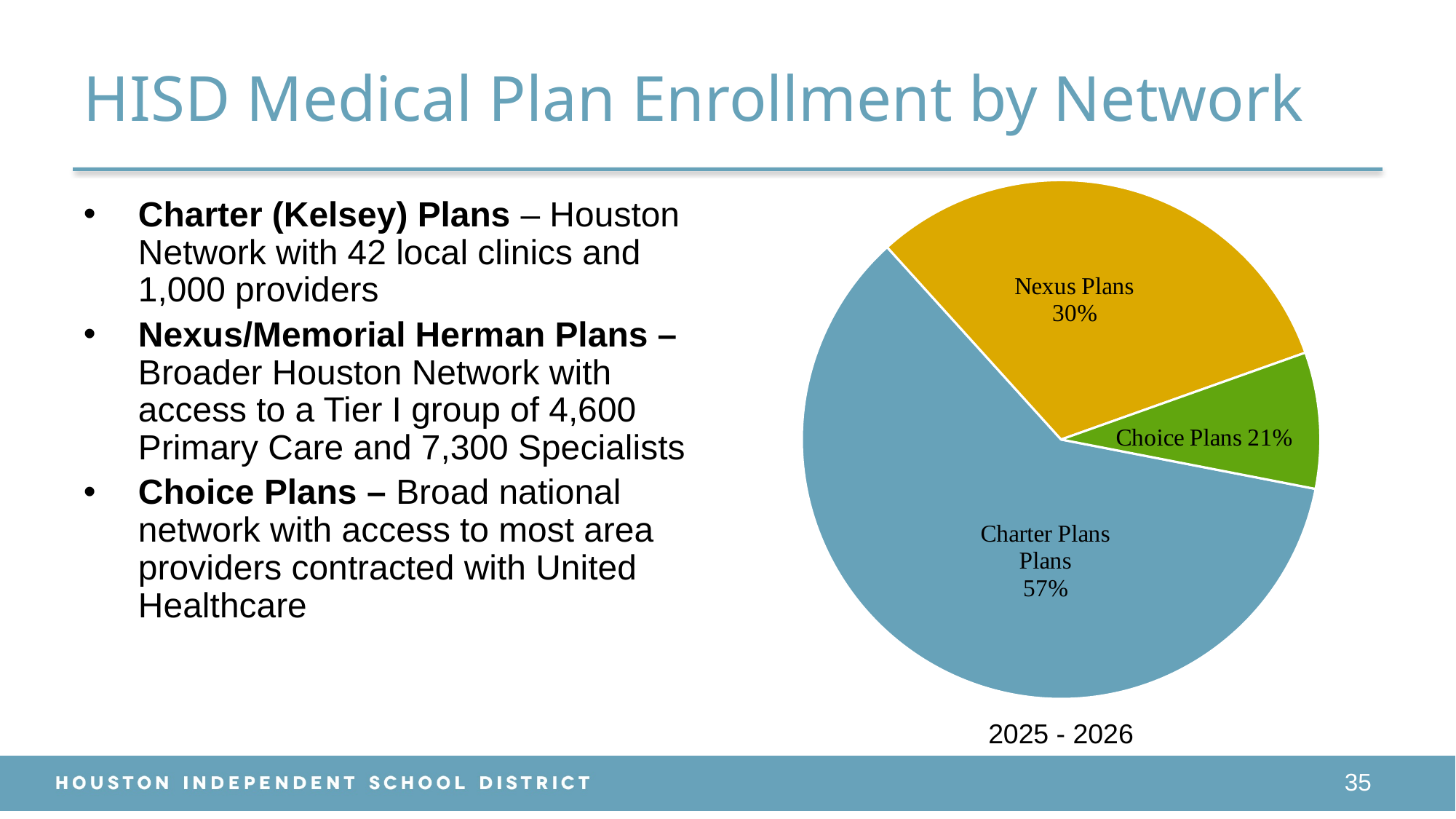
What kind of chart is shown on the slide? pie chart Which plan network has the smallest slice of the pie chart? Choice Plans What period label appears below the pie chart? 2025 - 2026 Which slice is larger, Nexus Plans or Choice Plans? Nexus Plans What share of the pie chart is labelled for Nexus Plans? 30% What colour is the Choice Plans slice of the pie chart? green What share of the pie chart is labelled for Choice Plans? 21% What is the difference in percentage points between the Charter Plans slice and the Nexus Plans slice? 27 What is the difference in percentage points between the Nexus Plans slice and the Choice Plans slice? 9 What share of the pie chart is labelled for Charter Plans? 57% Which plan network has the largest slice of the pie chart? Charter Plans How many slices does the pie chart have? 3